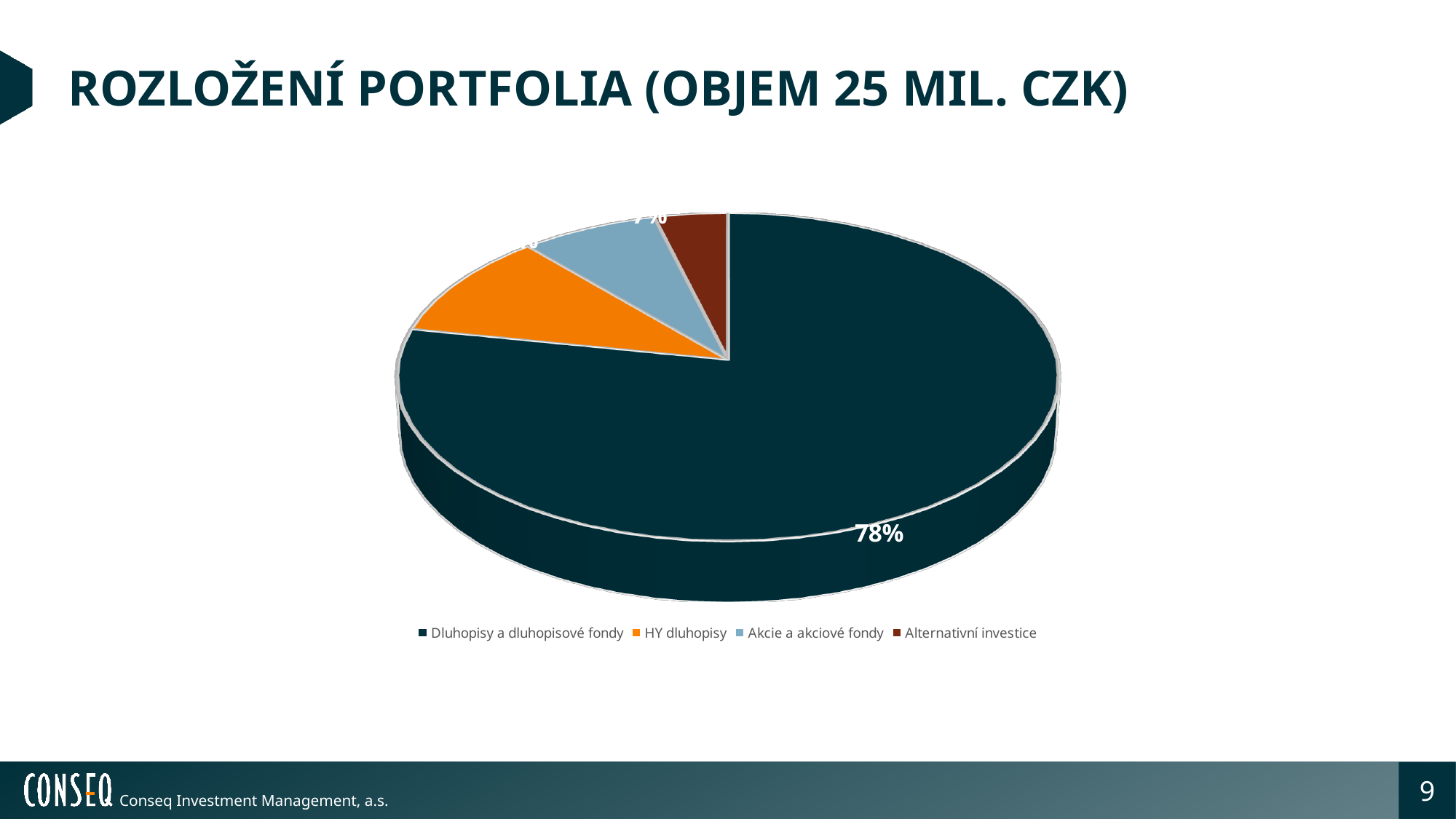
Which has a larger share: HY dluhopisy or Alternativní investice? HY dluhopisy Which has a larger share: Dluhopisy a dluhopisové fondy or HY dluhopisy? Dluhopisy a dluhopisové fondy Which has a larger share: HY dluhopisy or Akcie a akciové fondy? HY dluhopisy What percentage of the portfolio is in Dluhopisy a dluhopisové fondy? 78% Which category has the largest share of the portfolio? Dluhopisy a dluhopisové fondy Which category has the smallest share of the portfolio? Alternativní investice What kind of chart is shown on the slide? Pie chart How many entries does the legend list? 4 Which category is shown in orange in the pie chart? HY dluhopisy How many slices does the pie chart have? 4 What is the title of the slide? ROZLOŽENÍ PORTFOLIA (OBJEM 25 MIL. CZK)